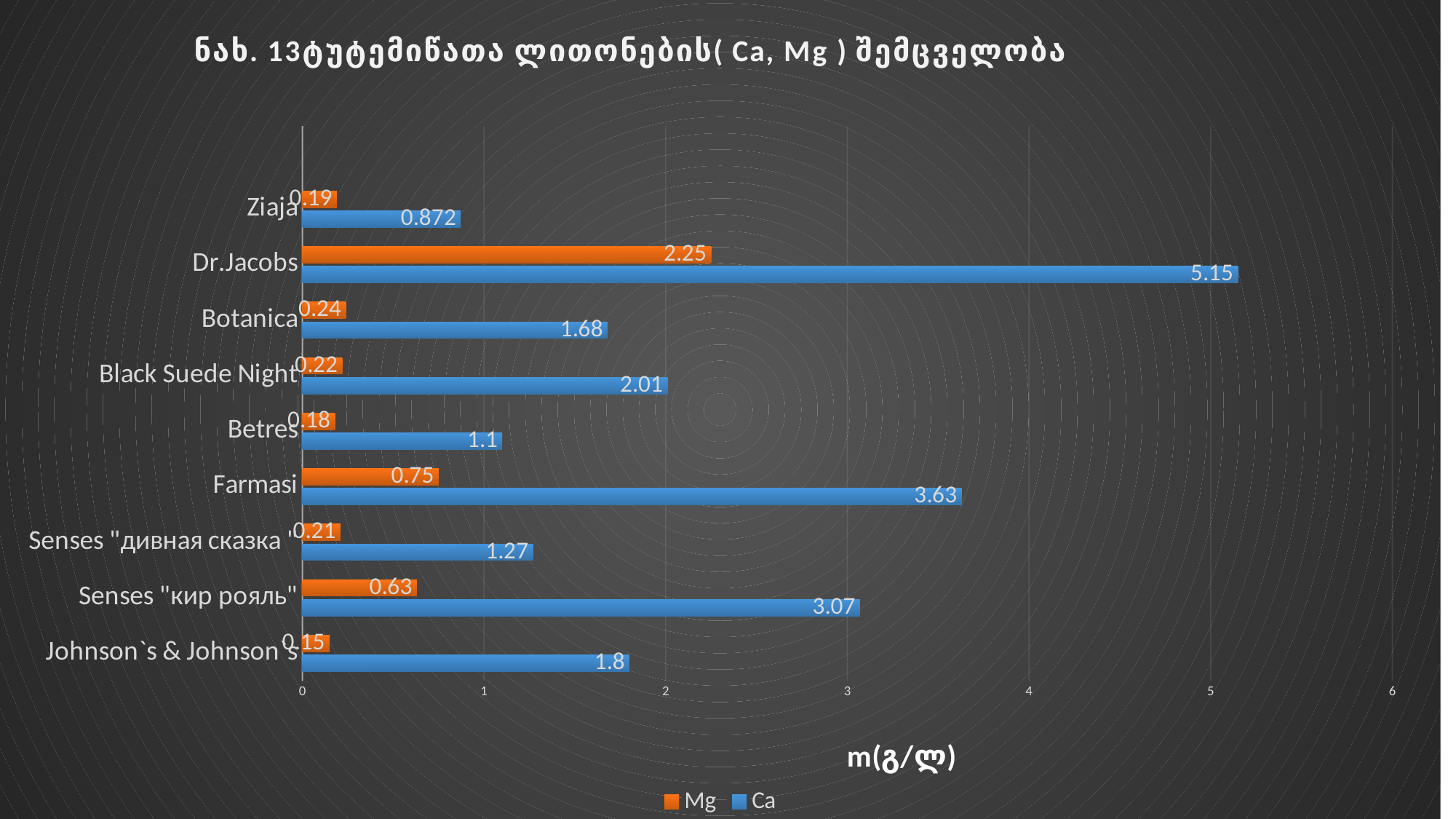
What is the Mg value for Farmasi? 0.75 What is the Ca value for Dr.Jacobs? 5.15 What is the Mg value for Senses "кир рояль"? 0.63 Which is larger, the Ca value for Botanica or the Ca value for Black Suede Night? Black Suede Night Which category has the lowest Mg value? Johnson`s & Johnson`s Which category has the highest Ca value? Dr.Jacobs What is the Ca value for Ziaja? 0.872 Is the Ca value for Johnson`s & Johnson`s greater or less than 2? less How many categories are shown on the chart? 9 What kind of chart is shown on the slide? bar chart What is the difference between the Ca values of Farmasi and Senses "кир рояль"? 0.56 How many series does the legend list? 2